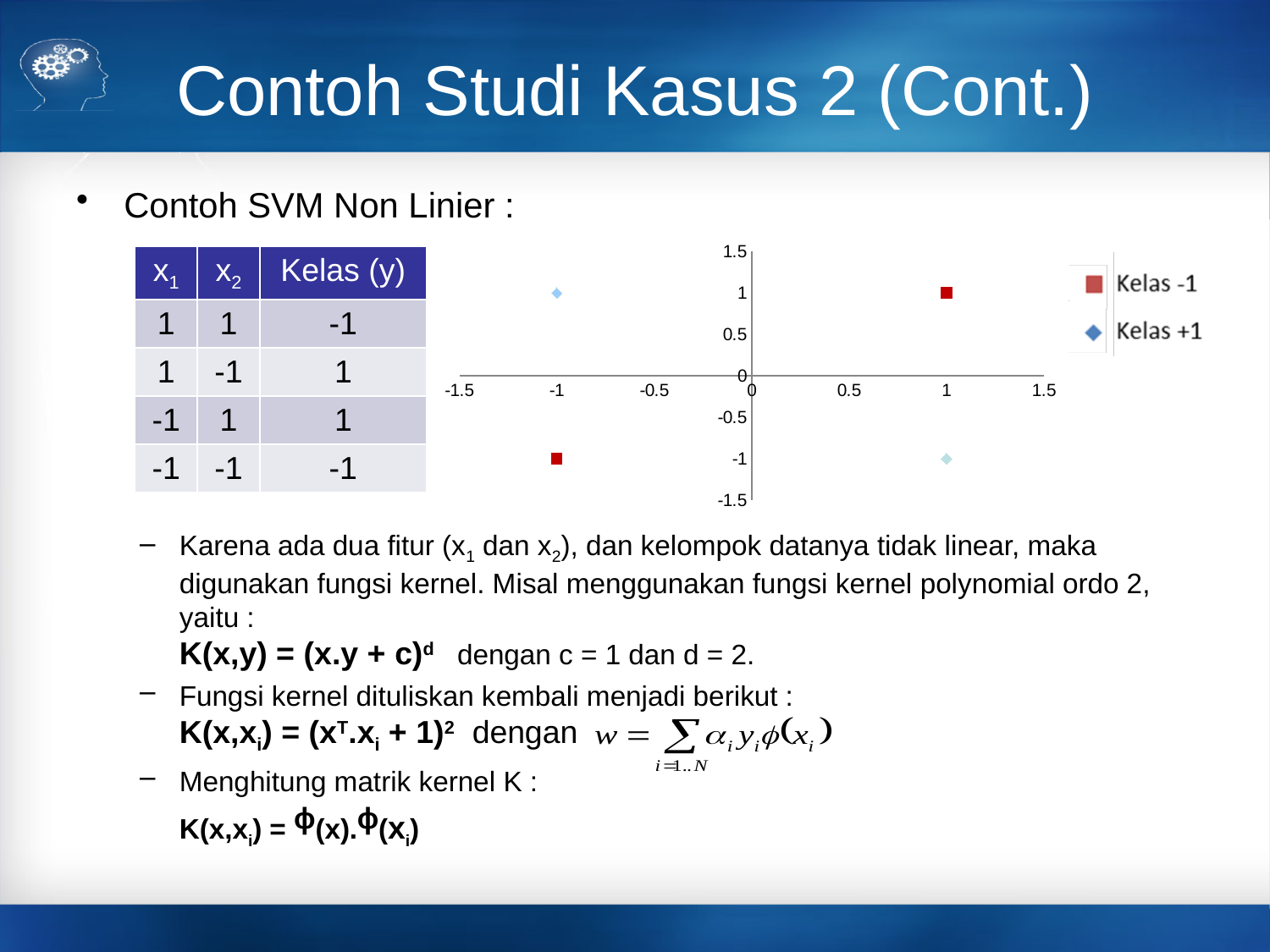
Is the x2 value of the Kelas -1 point at x1 = -1 greater or less than 0? less Which marker shape and colour represents the Kelas -1 series? red square What are the two series named in the chart legend? Kelas -1 and Kelas +1 How many points belong to the Kelas +1 series? 2 What is the maximum value shown on the vertical axis of the chart? 1.5 What is the x2 value of the Kelas +1 point that has x1 = 1? -1 What is the x1 value of the Kelas +1 point that has x2 = 1? -1 How many series does the chart legend list? 2 What is the x2 value of the Kelas -1 point that has x1 = 1? 1 Which series has a point in the upper-right quadrant of the chart (x1 = 1, x2 = 1)? Kelas -1 What kind of chart is shown on the slide? scatter chart How many points are plotted in the chart in total? 4